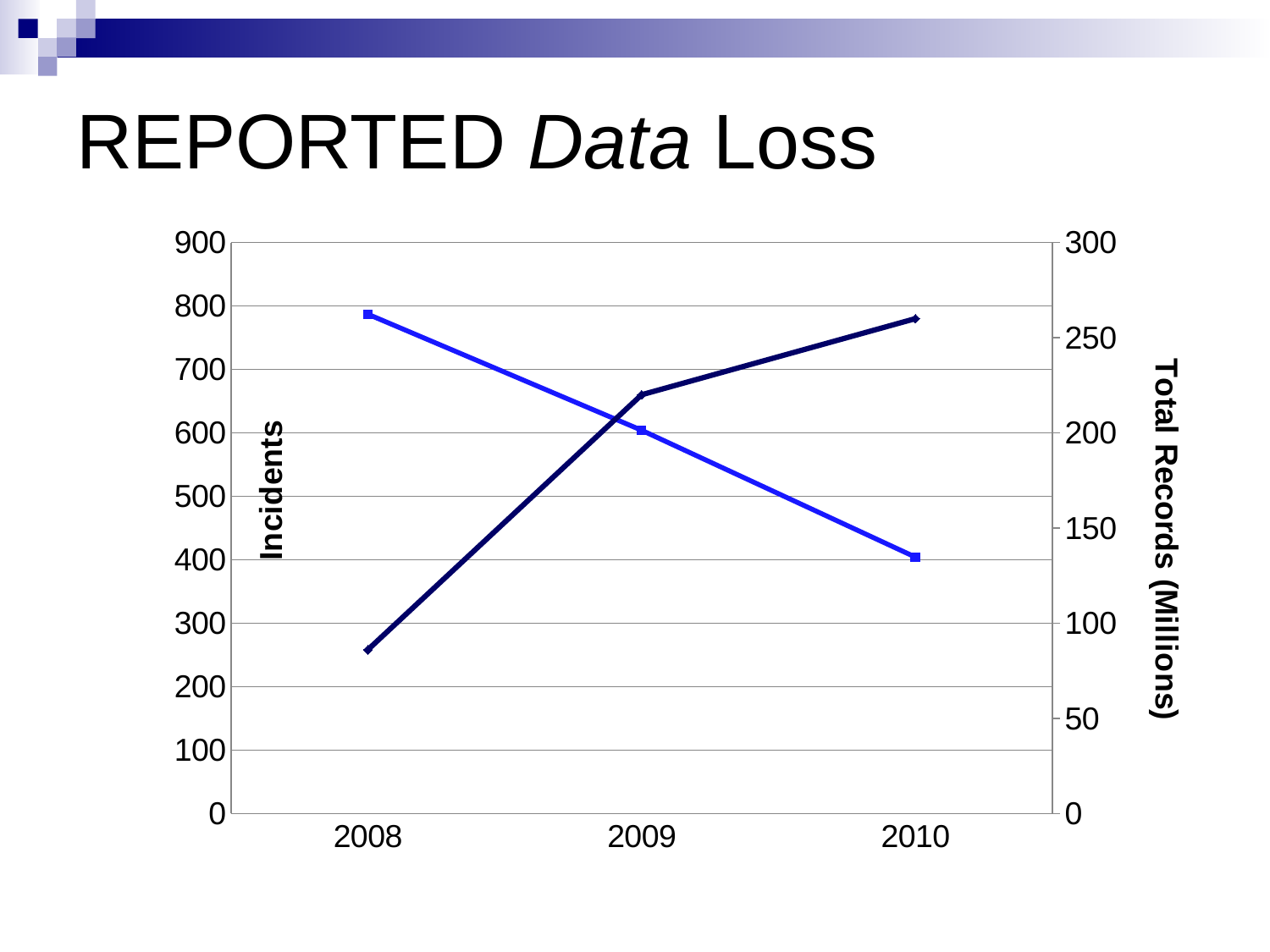
What kind of chart is shown on the slide? line chart How many lines are plotted on the chart? 2 Does the light blue line with square markers rise or fall from 2008 to 2010? fall Does the dark navy line with diamond markers rise or fall from 2008 to 2010? rise In which year does the dark navy line with diamond markers reach its lowest point? 2008 In 2008, which line is plotted higher on the chart: the light blue line or the dark navy line? the light blue line In which year does the dark navy line with diamond markers reach its highest point? 2010 In which year does the light blue line with square markers reach its lowest point? 2010 Read against the left-hand axis, is the light blue line's 2010 value greater or less than 500? less In which year does the light blue line with square markers reach its highest point? 2008 How many years are shown along the x axis of the chart? 3 What is the label on the right-hand vertical axis of the chart? Total Records (Millions)